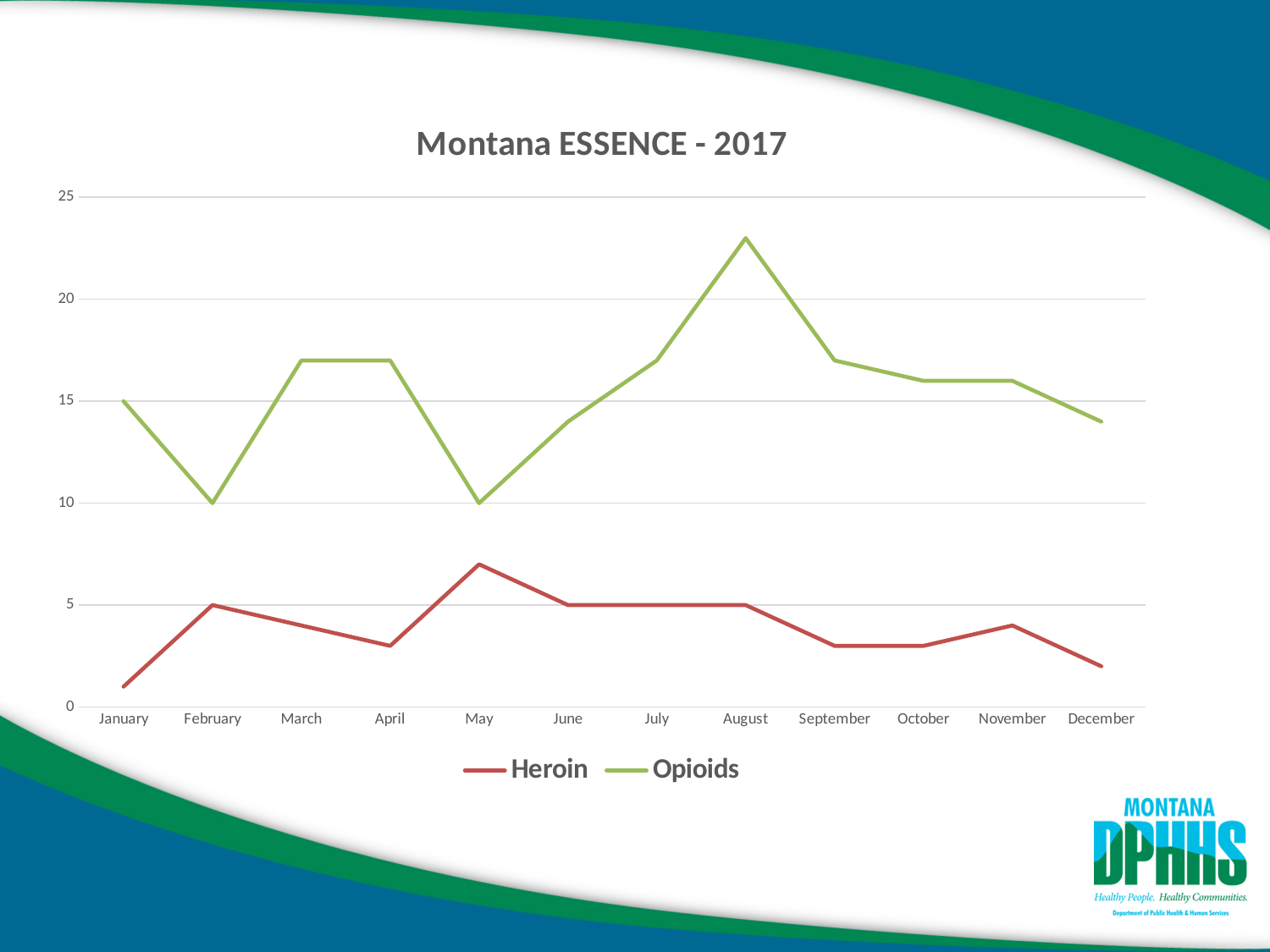
Does the Opioids series rise or fall from August to December? fall How many series does the legend list? 2 In which month does the Opioids series reach its highest value? August What is the Heroin value for February? 5 In which month is the Heroin value lowest? January What is the Opioids value for February? 10 What is the title of the chart? Montana ESSENCE - 2017 In which month does the Heroin series reach its highest value? May Is the Opioids value for August greater or less than 20? greater Which series has the higher value in December, Heroin or Opioids? Opioids What type of chart is shown on the slide? line chart How many months are plotted along the x axis? 12